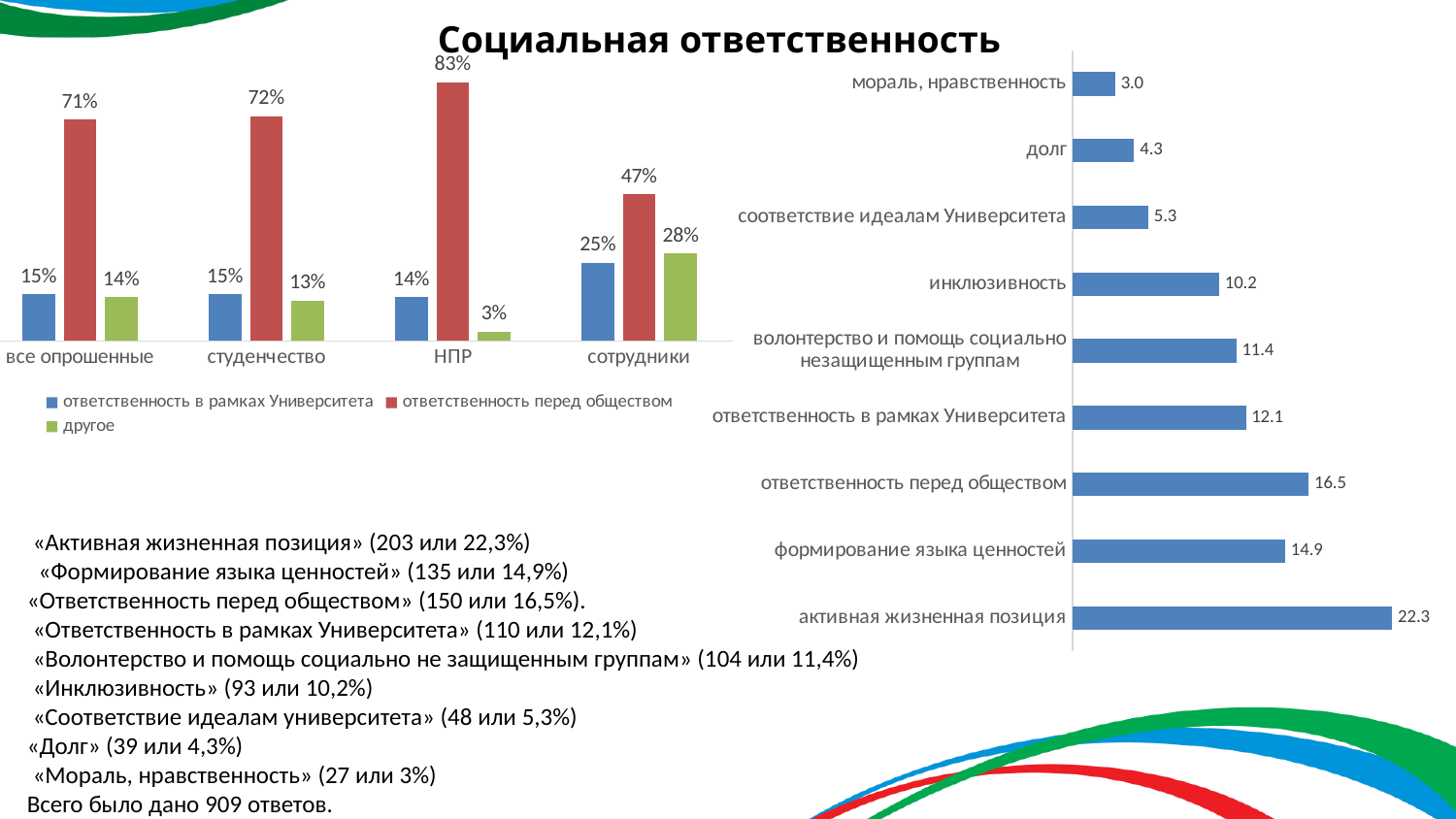
In the left chart, how many series does the legend list? 3 In the left chart, how many categories are shown on the x axis? 4 In the right chart, what is the difference between 'долг' and 'мораль, нравственность'? 1.3 What type of chart is the right chart? bar chart In the right chart, which is larger: 'ответственность перед обществом' or 'формирование языка ценностей'? ответственность перед обществом In the right chart, which category has the highest value? активная жизненная позиция In the left chart, which category has the highest value for 'ответственность перед обществом'? НПР In the right chart, what is the value for 'инклюзивность'? 10.2 In the left chart, what is the difference between 'ответственность перед обществом' and 'ответственность в рамках Университета' for 'сотрудники'? 22% In the left chart, what is the value for 'другое' for 'НПР'? 3% In the left chart, what is the value for 'ответственность перед обществом' for 'студенчество'? 72% In the right chart, which category has the lowest value? мораль, нравственность